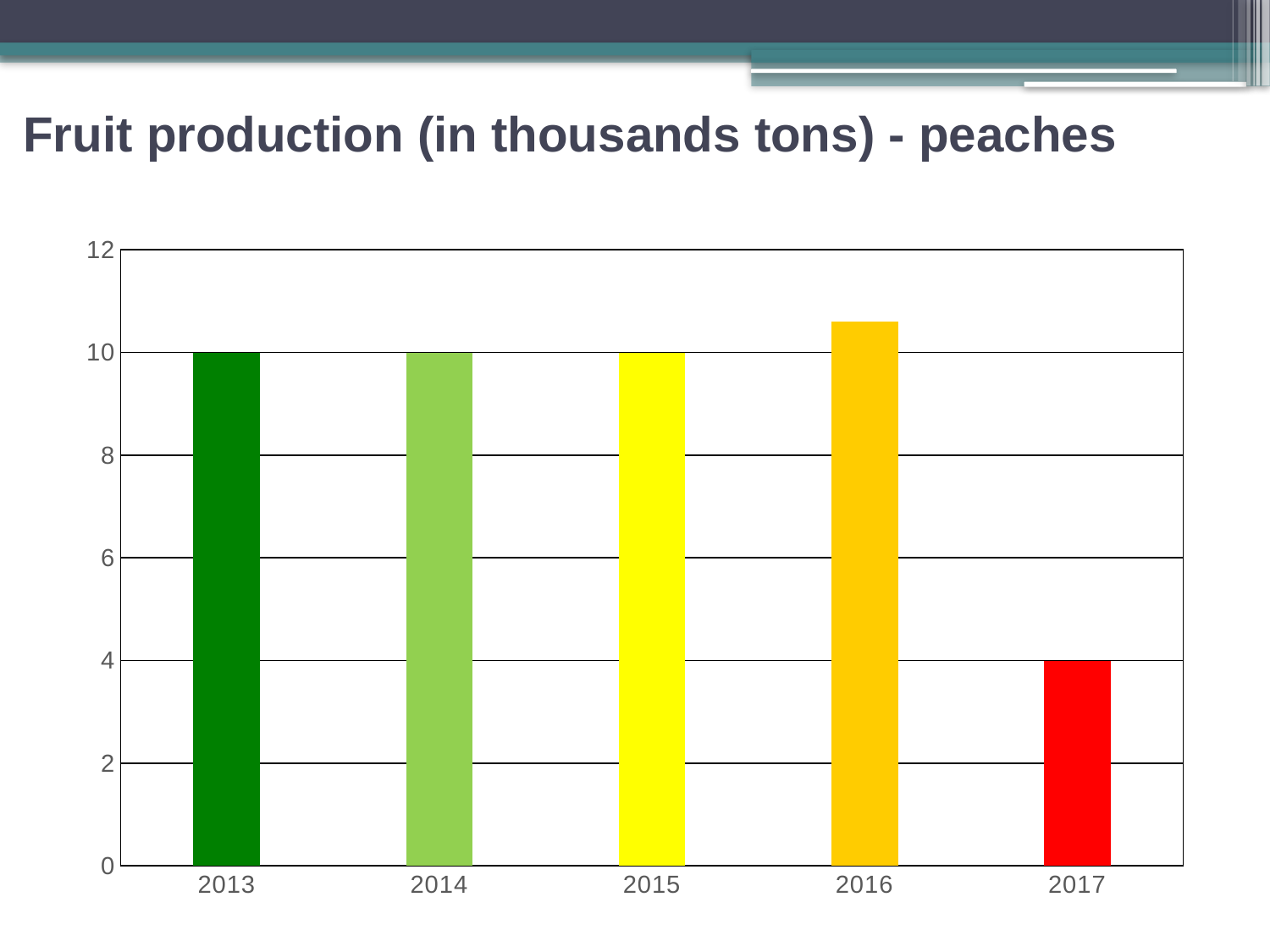
What colour is the bar for 2017? red What is the value for 2013? 10 Does the value rise or fall from 2016 to 2017? fall Which year has the lowest value? 2017 What is the value for 2015? 10 Is the value for 2016 greater or less than 10? greater How many years are shown on the x axis? 5 Which year has the highest value? 2016 What kind of chart is shown on the slide? bar chart What is the difference between the values for 2014 and 2017? 6 Which is larger, the value for 2016 or the value for 2017? 2016 What is the value for 2017? 4